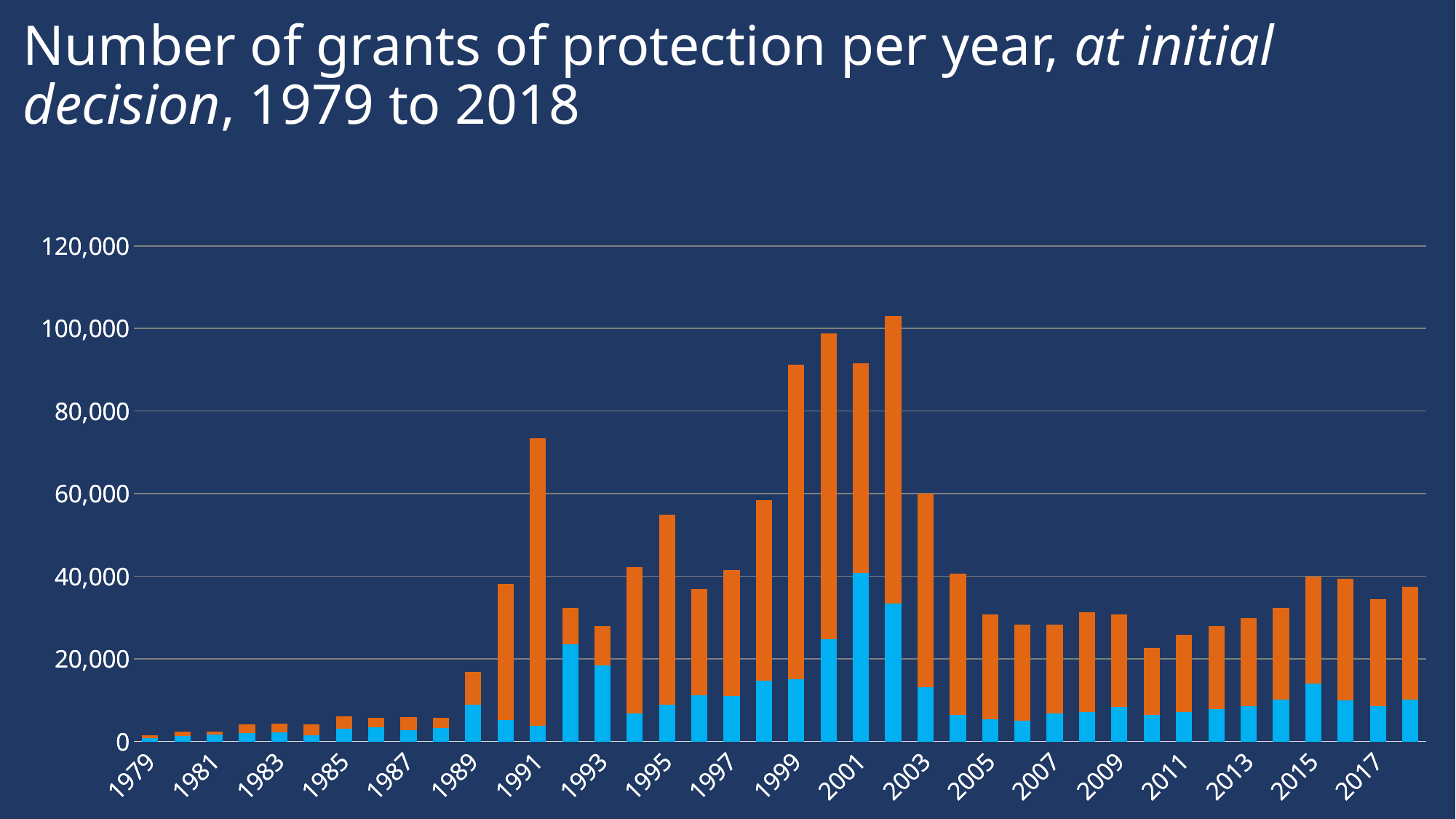
Which year has a larger total, 2005 or 2011? 2005 Is the total value for 1989 greater or less than 20,000? less Is the total value for 1995 greater or less than 60,000? less Which year has the lowest total number of grants of protection? 1979 Is the total value for 1991 greater or less than 60,000? greater Which year has the highest total number of grants of protection? 2002 What is the title of the chart? Number of grants of protection per year, at initial decision, 1979 to 2018 What kind of chart is shown on the slide? Stacked bar chart How many years (bars) are plotted on the chart? 40 Which year has a larger total, 1991 or 1995? 1991 Do the totals generally rise or fall from 2002 to 2011? fall